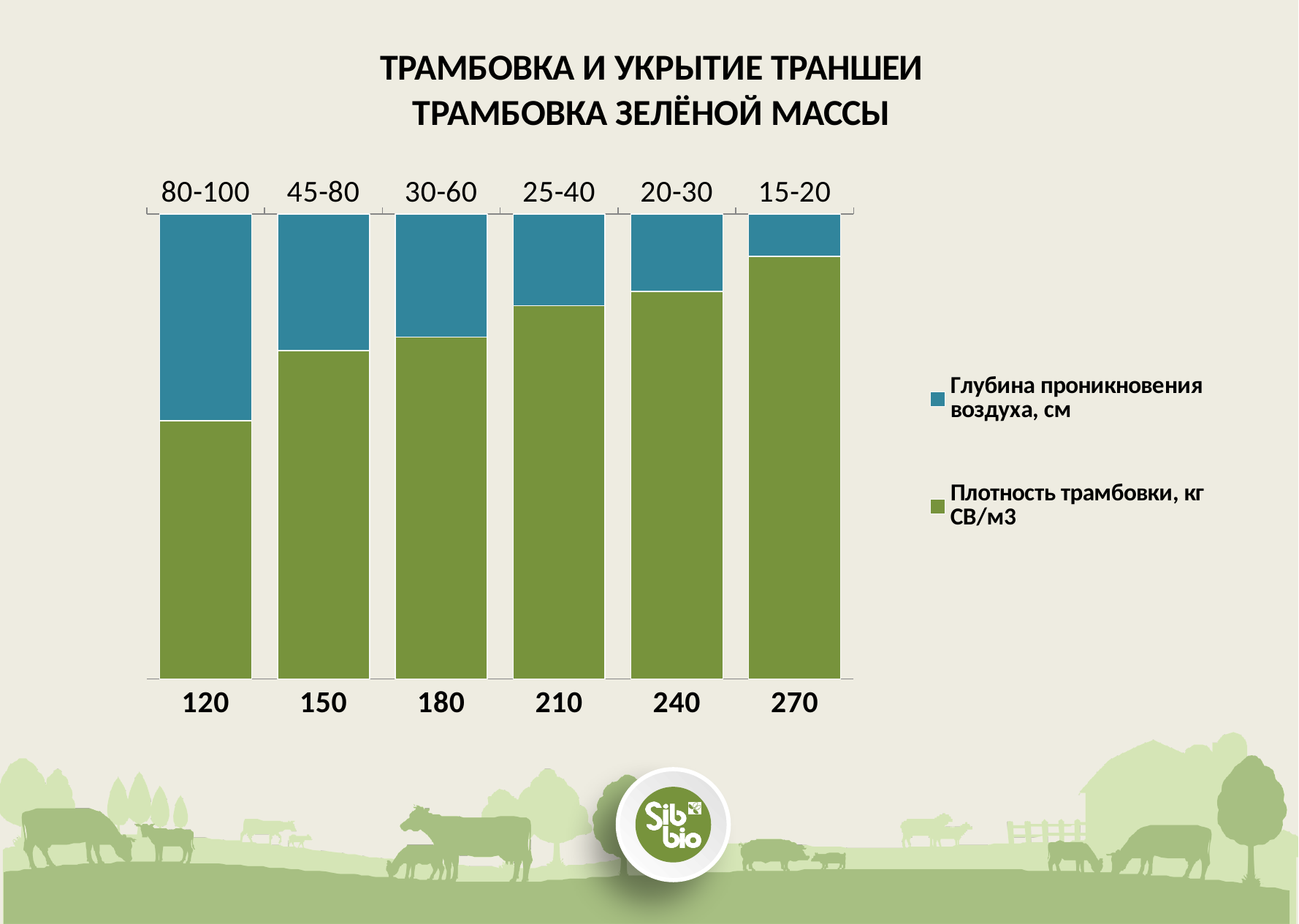
What air penetration depth (Глубина проникновения воздуха, см) is shown for the bar with compaction density 120? 80-100 Which bar has the smallest blue (air penetration) segment? 270 Which colour represents 'Плотность трамбовки, кг СВ/м3' in the legend? Green What kind of chart is shown on the slide? Stacked bar chart How many bars are shown in the chart? 6 What is the second line of the chart title? ТРАМБОВКА ЗЕЛЁНОЙ МАССЫ What air penetration depth is shown above the bar labelled 180? 30-60 Which compaction density value is labelled with an air penetration depth of 25-40? 210 Which bar has the largest blue (air penetration) segment? 120 How many series does the legend list? 2 As the compaction density increases from 120 to 270, does the air penetration depth rise or fall? Fall What air penetration depth is shown above the bar labelled 270? 15-20